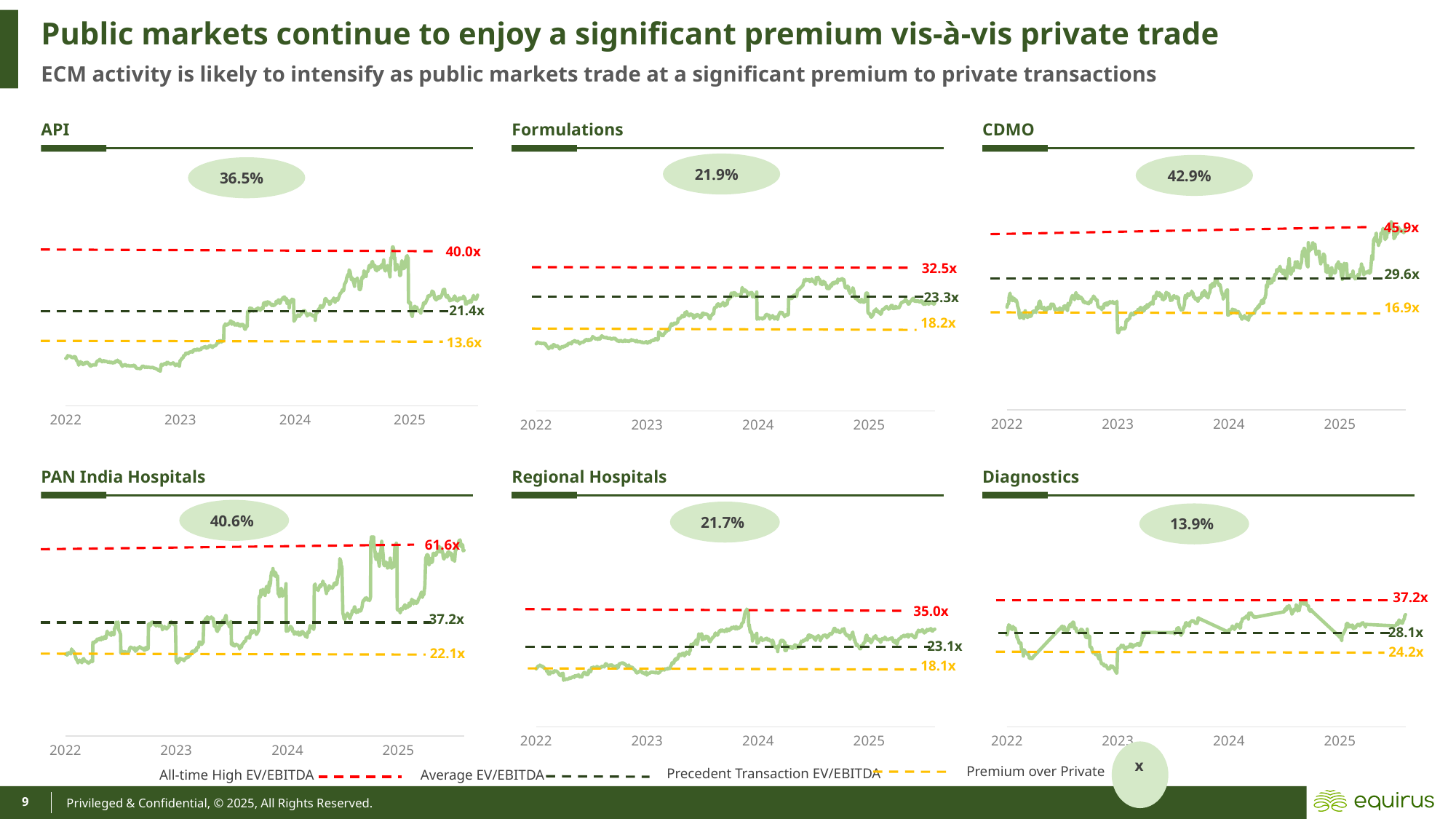
Which is larger: the Average EV/EBITDA on the Formulations chart or on the CDMO chart? CDMO Across the six charts, which sector shows the lowest premium over private? Diagnostics On the Diagnostics chart, what is the Average EV/EBITDA value? 28.1x How many year labels appear on the x axis of the Formulations chart? 4 On the CDMO chart, what is the Precedent Transaction EV/EBITDA value? 16.9x Across the six charts, which sector shows the highest All-time High EV/EBITDA? PAN India Hospitals On the API chart, what is the All-time High EV/EBITDA value? 40.0x On the API chart, what is the difference between the All-time High EV/EBITDA and the Average EV/EBITDA? 18.6x On the Regional Hospitals chart, what is the difference between the Average EV/EBITDA and the Precedent Transaction EV/EBITDA? 5.0x What kind of chart is used for each of the six sector panels? Line chart On the API chart, does the EV/EBITDA line generally rise or fall from 2022 to 2025? Rise What premium over private is shown in the bubble on the PAN India Hospitals chart? 40.6%